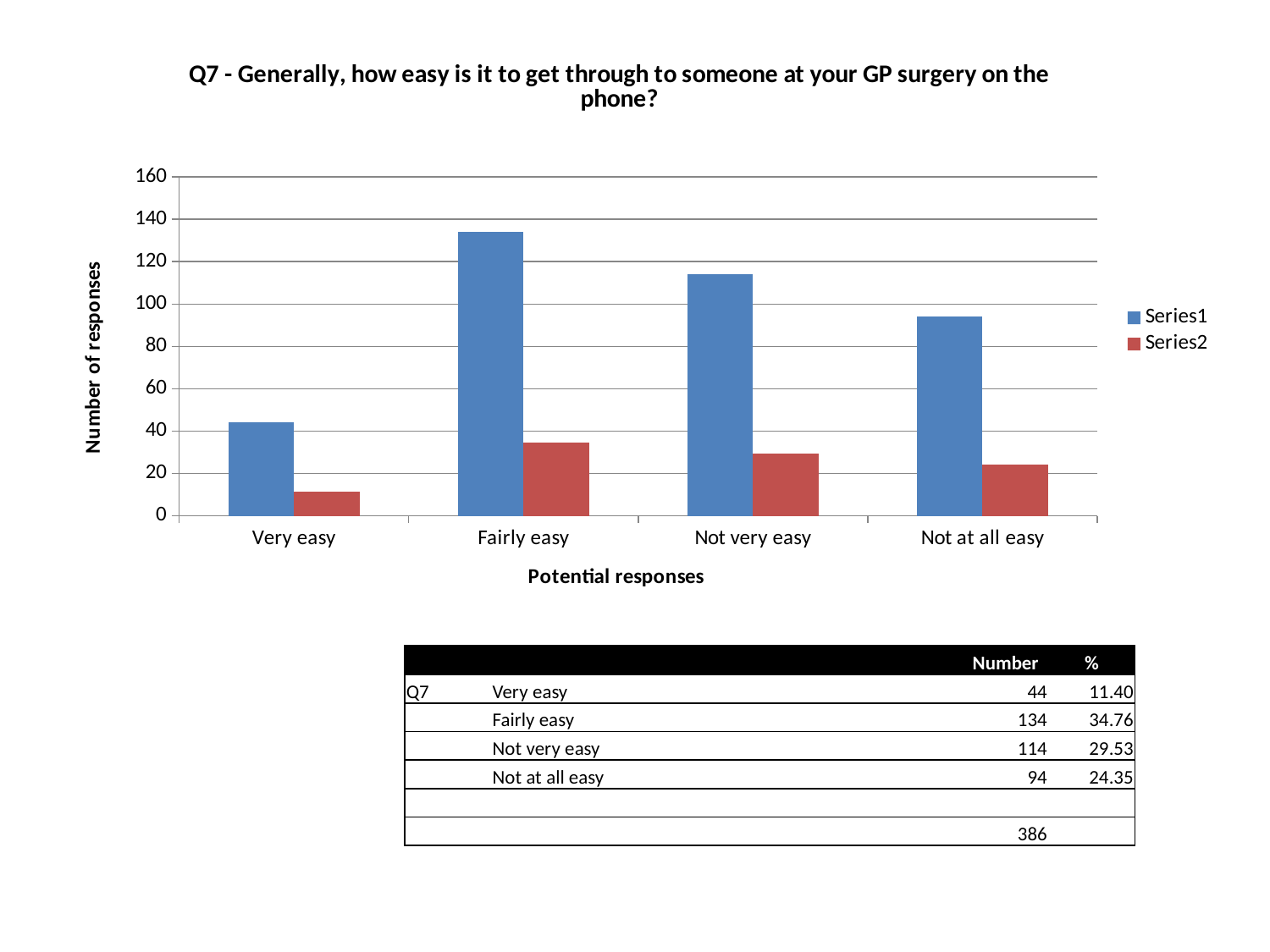
Is the Series1 value for Very easy greater or less than 60? less What is the Series2 value for Very easy? 11.40 How many series does the chart legend list? 2 How many categories are shown on the x axis of the chart? 4 What kind of chart is shown on the slide? bar chart What is the difference between the Series1 values for Fairly easy and Not very easy? 20 What is the Series1 value for Not at all easy? 94 Which is larger, the Series1 value for Not very easy or for Not at all easy? Not very easy Which category has the highest Series1 value? Fairly easy What is the label of the y axis of the chart? Number of responses Which category has the lowest Series1 value? Very easy What is the Series1 value for Fairly easy? 134